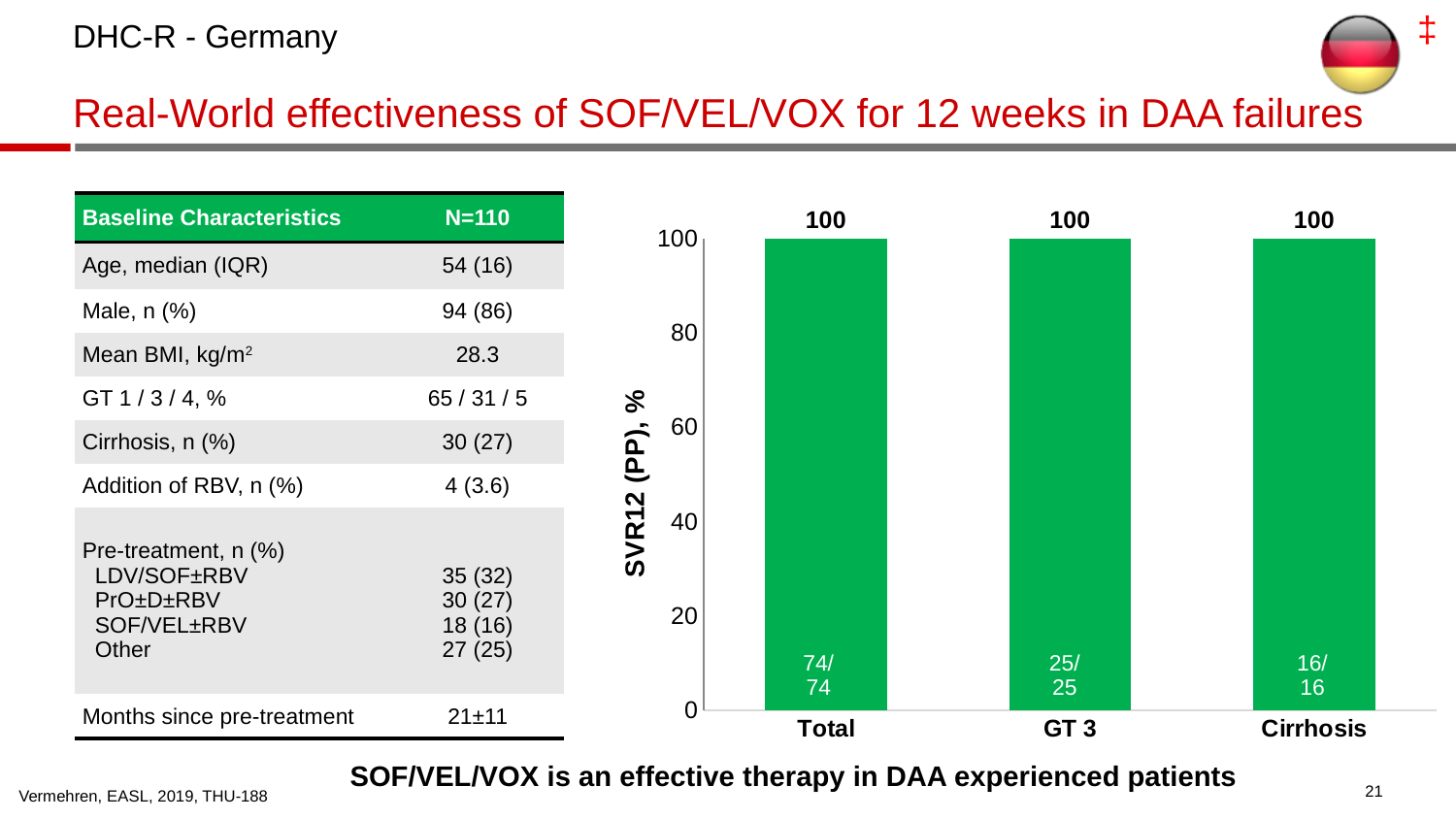
What colour are the bars in the chart? green How many categories are shown on the x axis of the chart? 3 What fraction of patients is shown inside the Total bar? 74/74 Is the SVR12 value for Cirrhosis greater or less than 80? greater What is the label of the y axis of the chart? SVR12 (PP), % What kind of chart is shown on the slide? bar chart What fraction of patients is shown inside the GT 3 bar? 25/25 What is the SVR12 value for the GT 3 group? 100 What fraction of patients is shown inside the Cirrhosis bar? 16/16 What is the SVR12 value for the Cirrhosis group? 100 What is the SVR12 value for the Total group? 100 What is the difference between the SVR12 values for Total and GT 3? 0